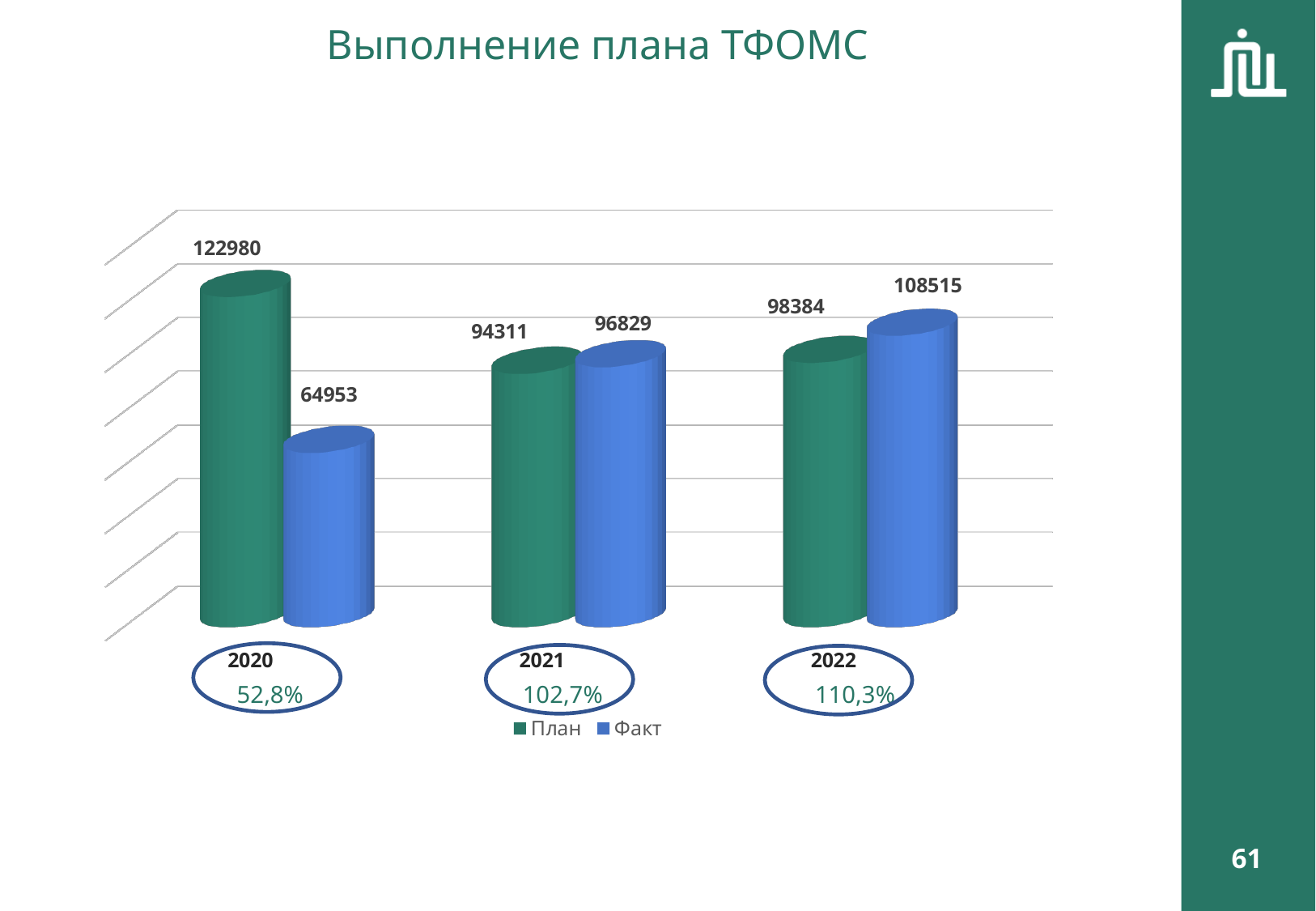
In 2021, which is larger, План or Факт? Факт What kind of chart is shown on the slide? Bar chart What is the Факт value for 2022? 108515 How many series does the legend list? 2 What is the difference between the План and Факт values for 2020? 58027 Which year has the highest План value? 2020 What is the План value for 2020? 122980 How many years are shown on the x axis? 3 What is the difference between the Факт and План values for 2022? 10131 What is the Факт value for 2021? 96829 Which year has the lowest Факт value? 2020 What percentage is shown below the 2022 bars? 110,3%